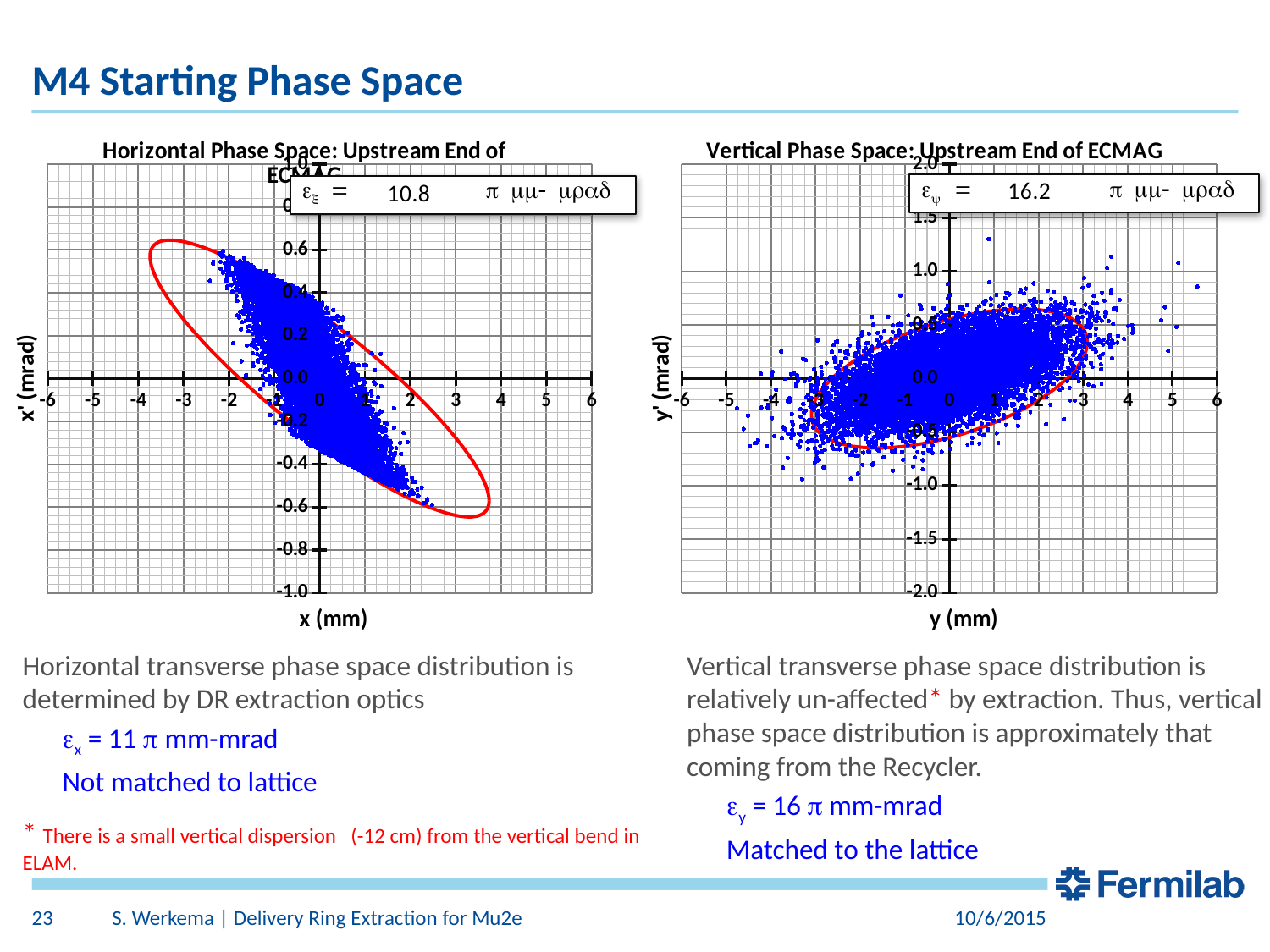
What kind of chart is the Vertical Phase Space chart on the right? scatter chart In the Vertical Phase Space chart, what emittance value is printed in the box at the top of the plot? 16.2 In the Horizontal Phase Space chart, do the scattered points trend upward or downward as x increases? downward What is the x-axis title of the Horizontal Phase Space chart? x (mm) In the Horizontal Phase Space chart, is the largest x' value reached by the scattered points greater or less than 1.0? less What kind of chart is the Horizontal Phase Space chart on the left? scatter chart Which chart shows the larger printed emittance value, the Horizontal Phase Space chart or the Vertical Phase Space chart? Vertical Phase Space chart What is the y-axis title of the Vertical Phase Space chart? y' (mrad) What is the difference between the emittance values printed on the Vertical and Horizontal Phase Space charts? 5.4 In the Vertical Phase Space chart, is the largest y' value reached by the scattered points greater or less than 1.5? less In the Horizontal Phase Space chart, what emittance value is printed in the box at the top of the plot? 10.8 In the Vertical Phase Space chart, do the scattered points trend upward or downward as y increases? upward